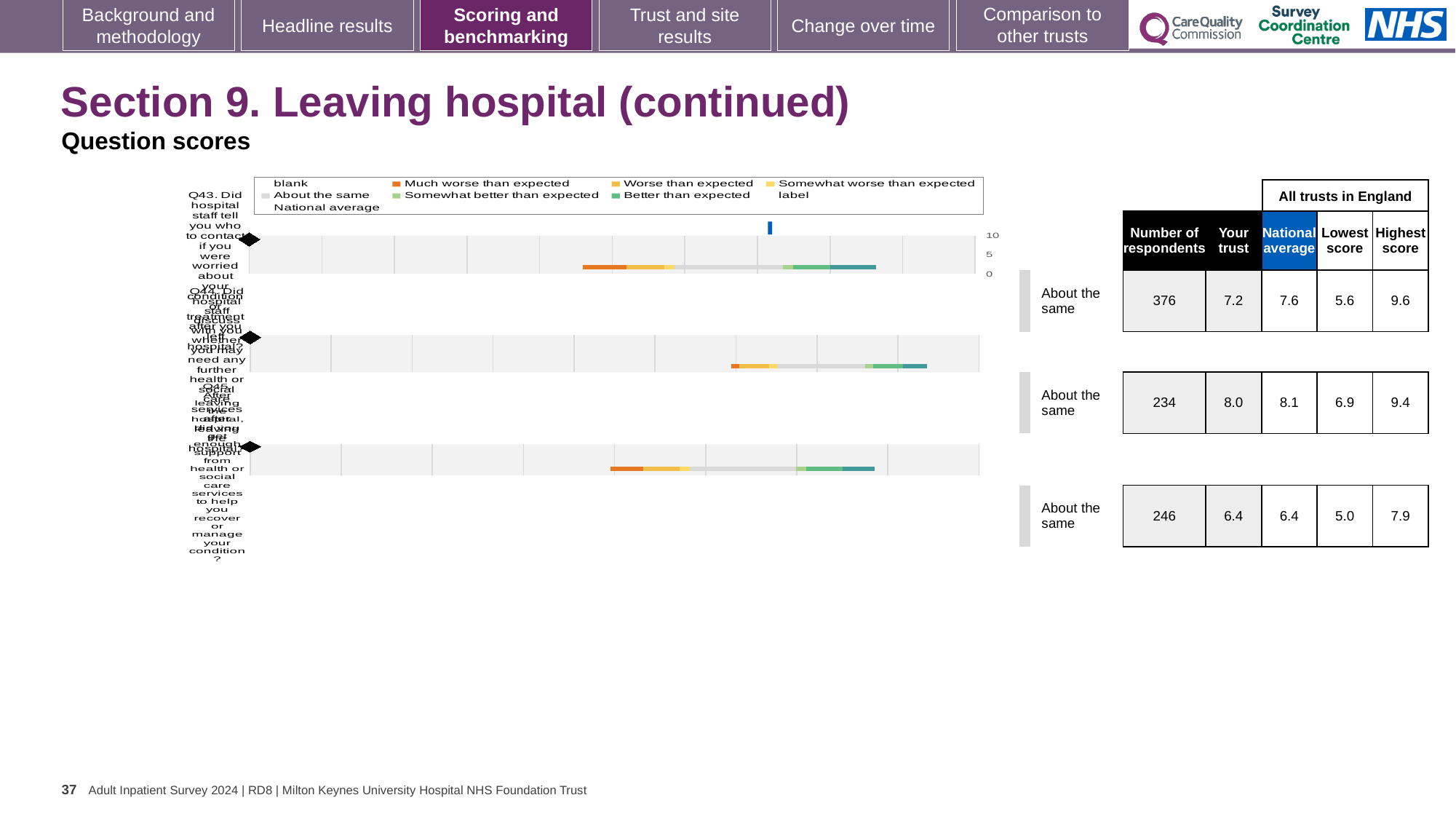
How many entries does the chart legend list? 9 What benchmark category is given for the third question row (Q45)? About the same In the table, what is the national average for the second row (Q44)? 8.1 What is the highest value shown on the chart's axis? 10 In the table, which row has the highest 'Your trust' score: the first (Q43), second (Q44) or third (Q45)? second (Q44) What benchmark category is given for the first question row (Q43)? About the same How many question bars are plotted in the chart? 3 Which legend entry is shown in orange? Much worse than expected In the table, what is the 'Your trust' score for the first row (Q43)? 7.2 In the table, what is the difference between the highest score and the lowest score for the first row (Q43)? 4.0 What kind of chart is shown on the slide? bar chart In the table, what is the number of respondents for the third row (Q45)? 246